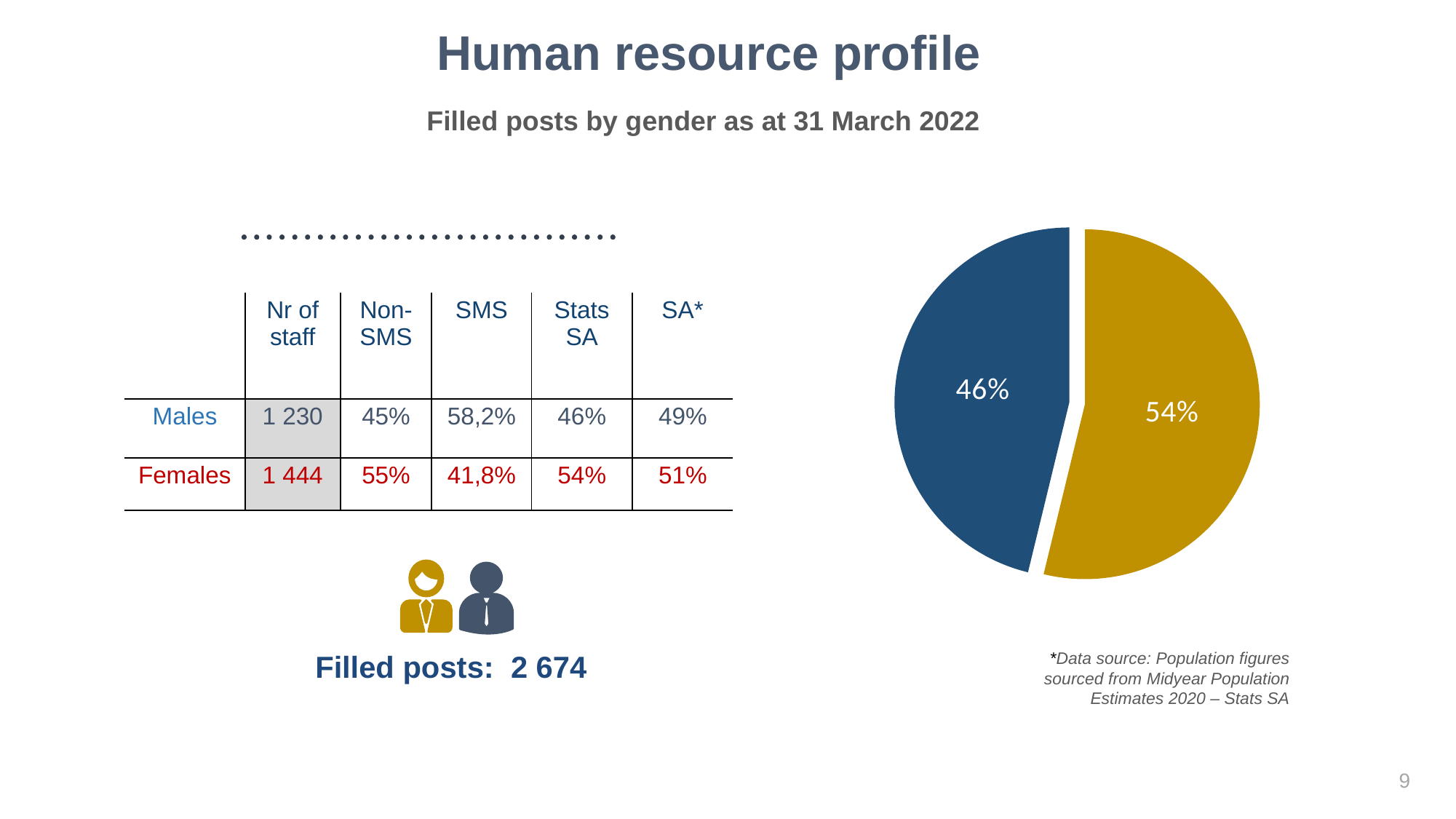
What share of the pie chart does the gold slice represent? 54% What is the difference in percentage points between the gold slice and the blue slice of the pie chart? 8 percentage points What kind of chart is shown on the right of the slide? pie chart How many slices does the pie chart have? 2 Does the pie chart include a legend? No Which slice of the pie chart is the largest? the gold slice (54%) Which slice of the pie chart is the smallest? the blue slice (46%) Which is larger in the pie chart, the blue slice or the gold slice? the gold slice What percentage is shown on the gold slice of the pie chart? 54% What do the two slices of the pie chart add up to? 100% What two colours are used for the slices of the pie chart? blue and gold What percentage is shown on the blue slice of the pie chart? 46%